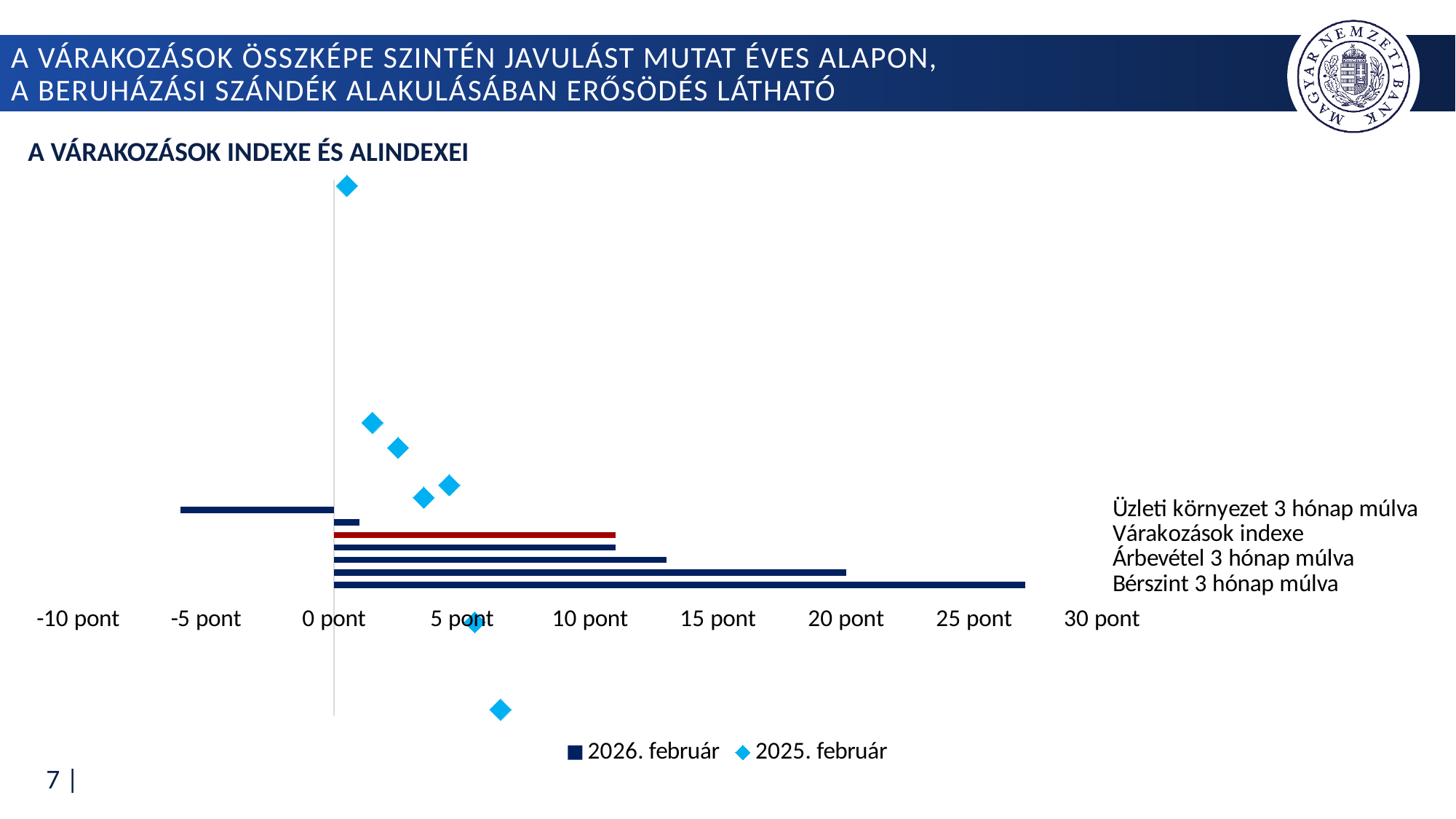
Is the 2026. február value for Árbevétel 3 hónap múlva greater or less than 10 pont? greater Which has the larger 2026. február value, Bérszint 3 hónap múlva or Árbevétel 3 hónap múlva? Bérszint 3 hónap múlva Is the 2026. február value for Bérszint 3 hónap múlva greater or less than 20 pont? greater How many series does the legend list? 2 Which category has the longest 2026. február bar? Bérszint 3 hónap múlva What is the title of the chart? A VÁRAKOZÁSOK INDEXE ÉS ALINDEXEI Which category has the lowest 2026. február value? Üzleti környezet 3 hónap múlva Which series is shown with diamond markers? 2025. február Is the 2026. február value for Üzleti környezet 3 hónap múlva greater or less than 0 pont? less What kind of chart is shown on the slide? bar chart Which two series are listed in the legend? 2026. február and 2025. február